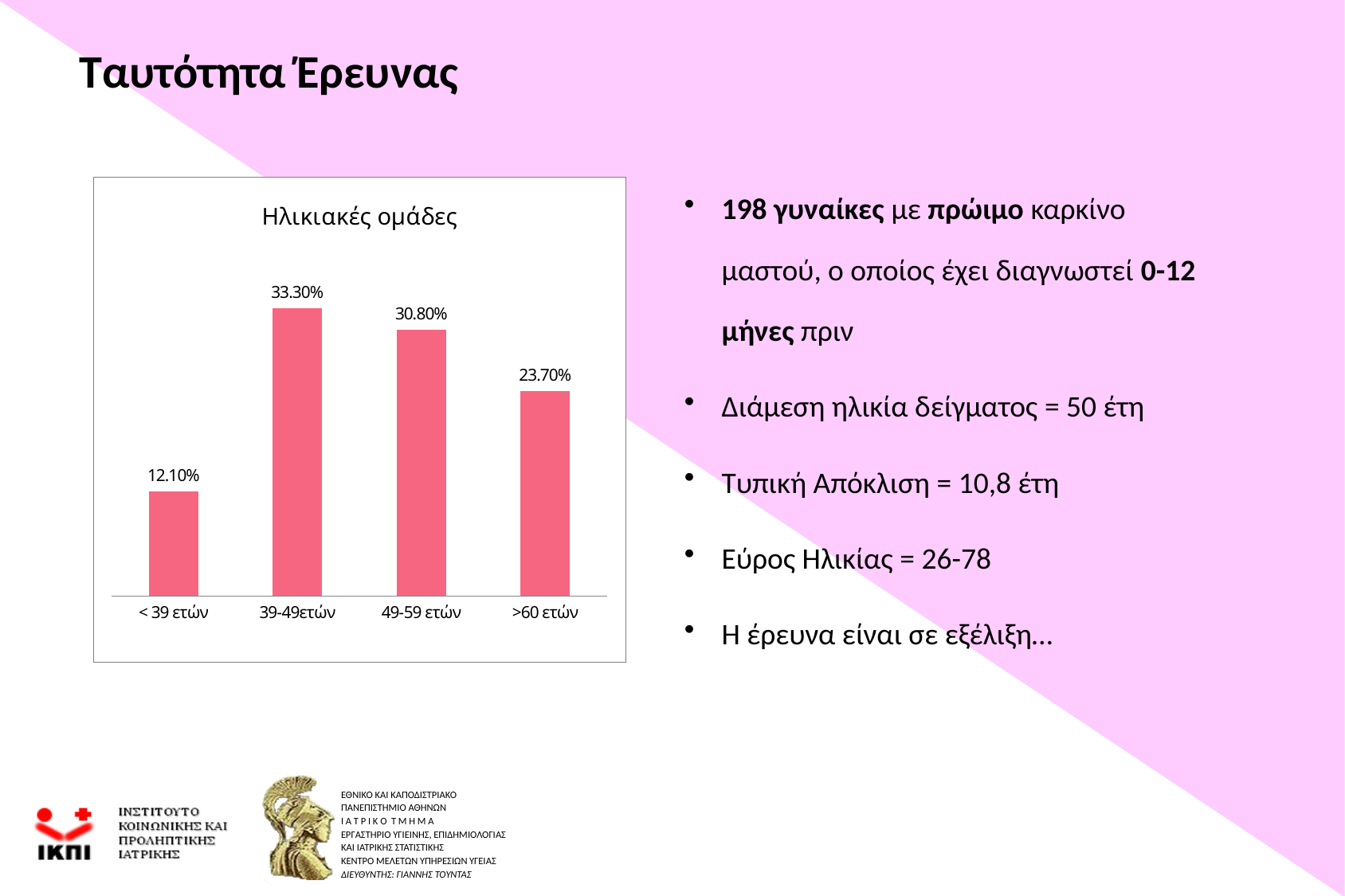
Which age group has the highest value? 39-49ετών What is the value for the '49-59 ετών' age group? 30.80% Which age group has the lowest value? < 39 ετών What is the difference between the values for '39-49ετών' and '>60 ετών'? 9.60% What is the title of the chart? Ηλικιακές ομάδες What kind of chart is shown on the slide? Bar chart What is the value for the '>60 ετών' age group? 23.70% Which is larger, the value for '49-59 ετών' or the value for '>60 ετών'? 49-59 ετών How many age groups are shown in the chart? 4 What is the value for the '39-49ετών' age group? 33.30% What is the difference between the values for '49-59 ετών' and '< 39 ετών'? 18.70% What is the value for the '< 39 ετών' age group? 12.10%